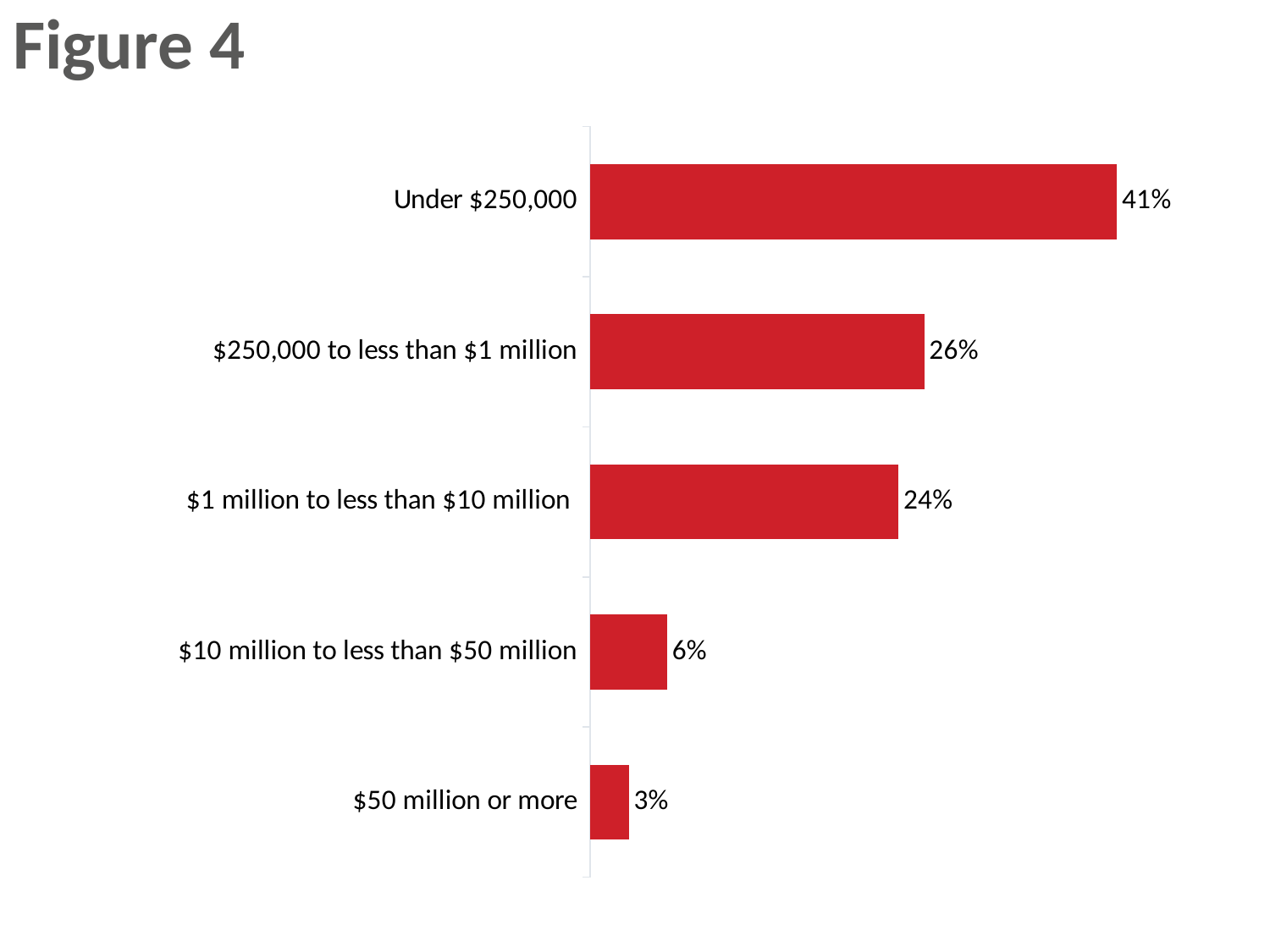
Which category has the highest value? Under $250,000 What is the difference between the values for $10 million to less than $50 million and $50 million or more? 3% Which is larger, the value for $250,000 to less than $1 million or the value for $1 million to less than $10 million? $250,000 to less than $1 million What kind of chart is shown on the slide? Bar chart What is the value for $250,000 to less than $1 million? 26% What is the value for Under $250,000? 41% What is the value for $50 million or more? 3% Which category has the lowest value? $50 million or more How many categories are shown in the chart? 5 What is the value for $10 million to less than $50 million? 6% What is the value for $1 million to less than $10 million? 24% What is the difference between the values for Under $250,000 and $250,000 to less than $1 million? 15%